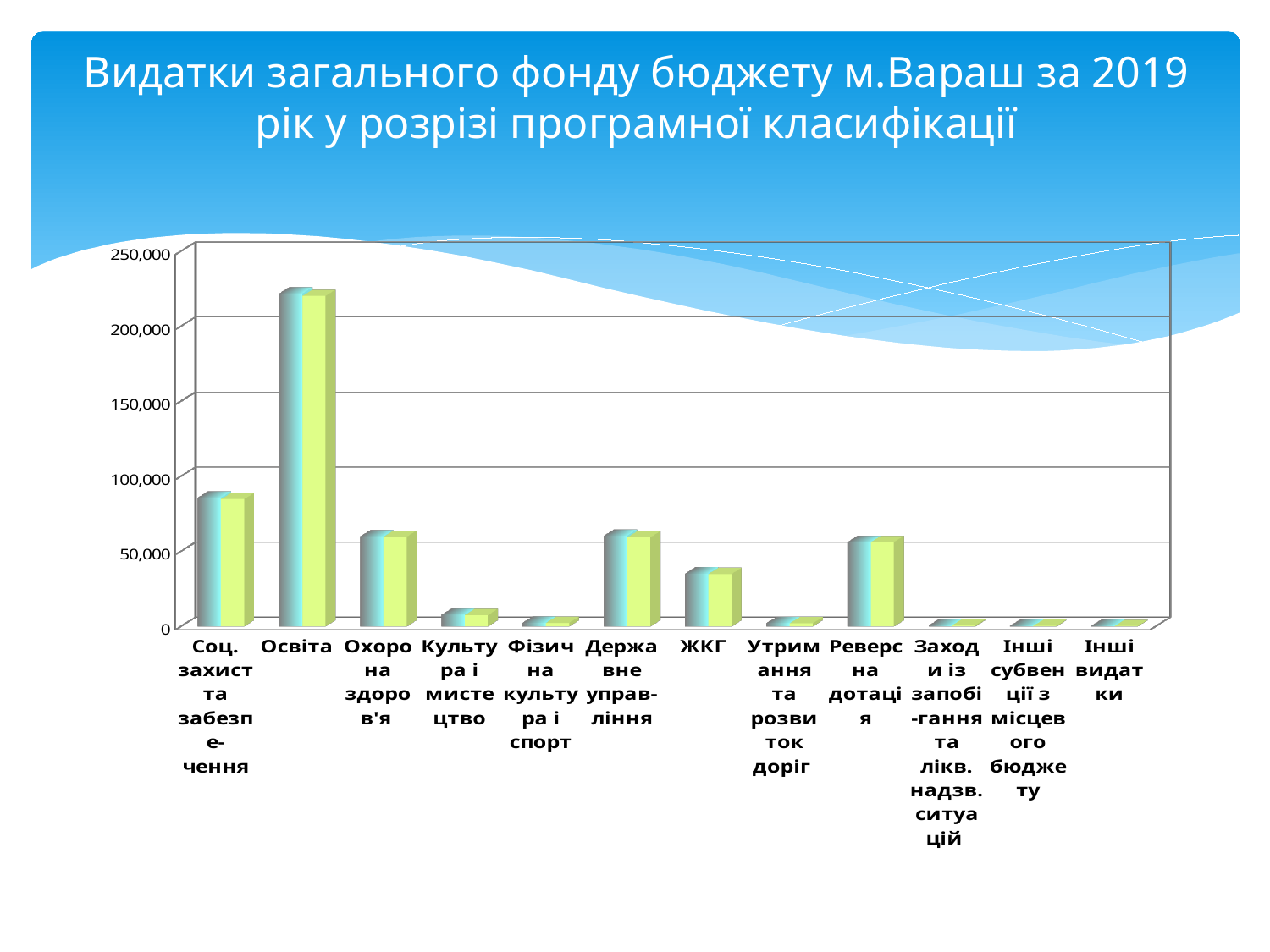
Is the value for Культура і мистецтво greater or less than 50,000? less Is the value for Освіта greater or less than 200,000? greater What is the title of the slide containing the chart? Видатки загального фонду бюджету м.Вараш за 2019 рік у розрізі програмної класифікації How many categories are shown on the x axis of the chart? 12 Which is larger, the value for Реверсна дотація or the value for ЖКГ? Реверсна дотація Which is larger, the value for Освіта or the value for Соц. захист та забезпечення? Освіта Is the value for Соц. захист та забезпечення greater or less than 50,000? greater Which category has the highest value in the chart? Освіта What kind of chart is shown on the slide? bar chart